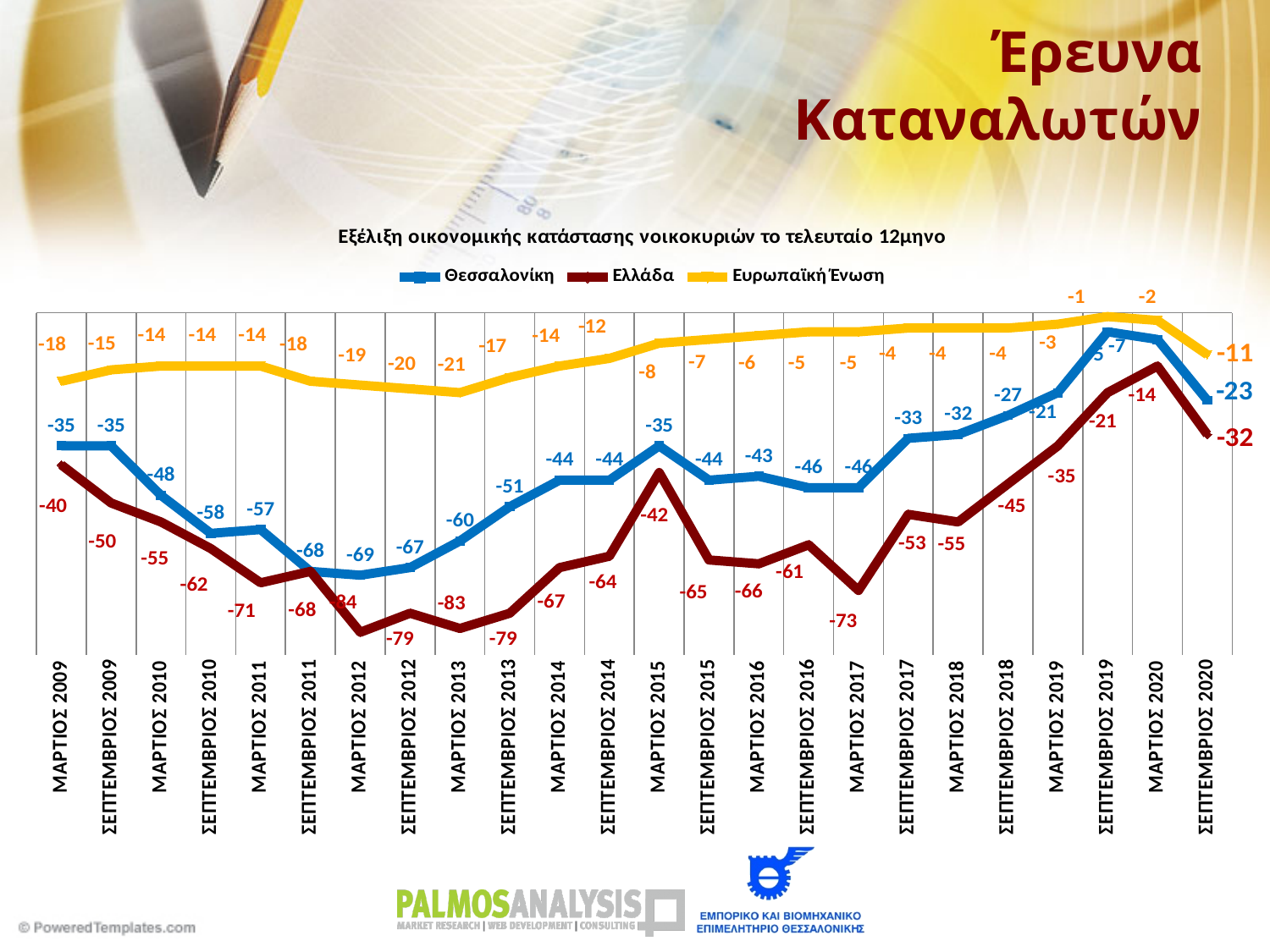
How many series does the legend list? 3 What kind of chart is shown on the slide? Line chart What is the value for Ελλάδα in ΜΑΡΤΙΟΣ 2012? -84 What is the value for Θεσσαλονίκη in ΣΕΠΤΕΜΒΡΙΟΣ 2020? -23 What colour is the line for Ευρωπαϊκή Ένωση? Yellow How many time points are plotted along the x axis? 24 In which period does the Ευρωπαϊκή Ένωση series reach its highest value? ΣΕΠΤΕΜΒΡΙΟΣ 2019 In which period does the Ελλάδα series reach its lowest value? ΜΑΡΤΙΟΣ 2012 What is the value for Ελλάδα in ΜΑΡΤΙΟΣ 2020? -14 What is the difference between the Θεσσαλονίκη and Ελλάδα values in ΜΑΡΤΙΟΣ 2009? 5 In ΜΑΡΤΙΟΣ 2015, which series has the higher value, Θεσσαλονίκη or Ελλάδα? Θεσσαλονίκη What is the value for Ευρωπαϊκή Ένωση in ΣΕΠΤΕΜΒΡΙΟΣ 2020? -11